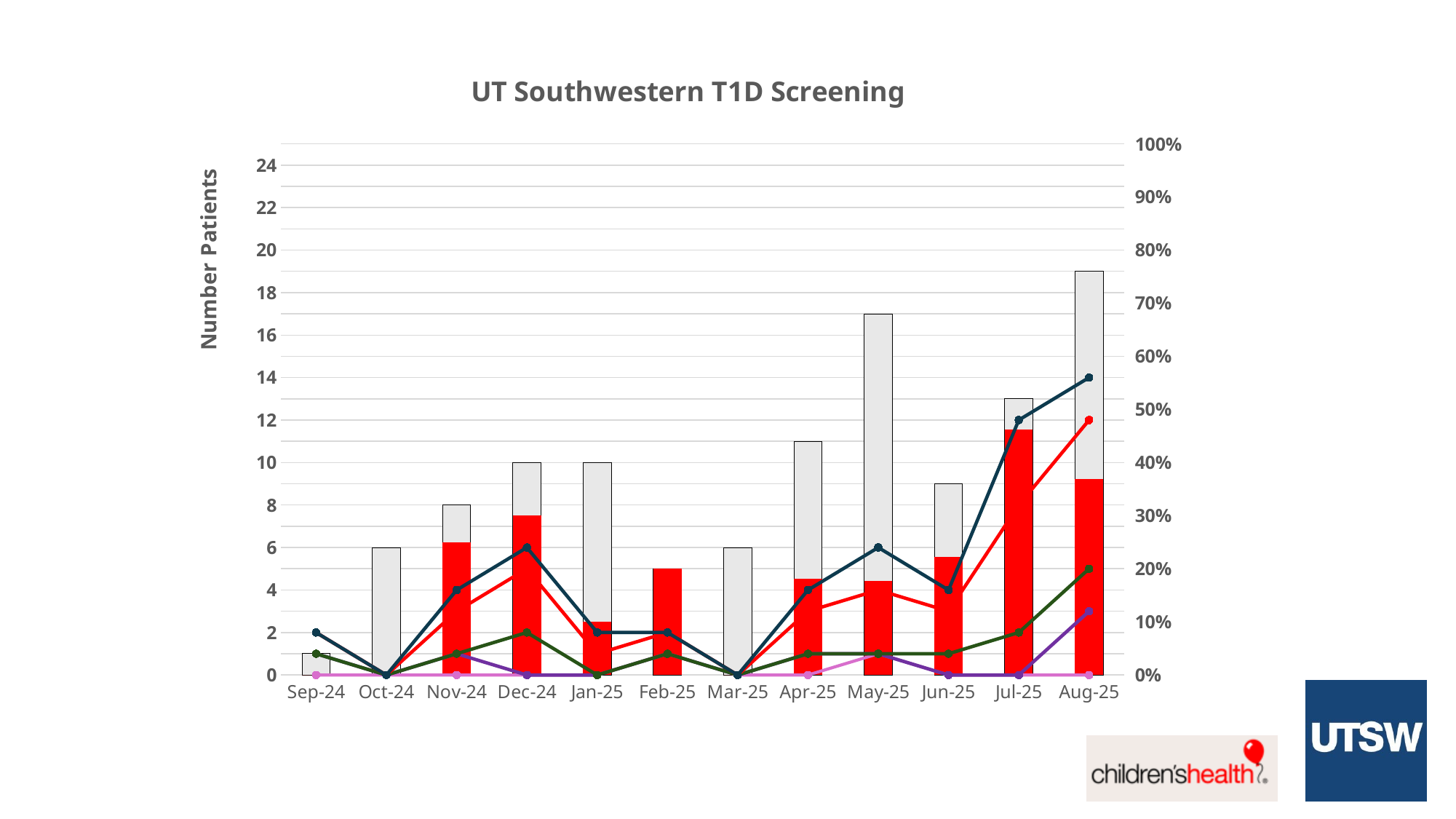
Which month has the taller gray bar, May-25 or Jun-25? May-25 How many months are shown along the x axis? 12 What is the label on the left vertical axis? Number Patients What is the height of the gray bar for Nov-24? 8 What kind of chart is shown on the slide? Combined bar and line chart Which month has the tallest gray bar? Aug-25 What is the height of the gray bar for Dec-24? 10 What is the title of the chart? UT Southwestern T1D Screening Is the gray bar for May-25 greater or less than 16? greater What is the height of the gray bar for Oct-24? 6 Which month has the shortest gray bar? Sep-24 What is the difference between the gray bar heights for Dec-24 and Oct-24? 4